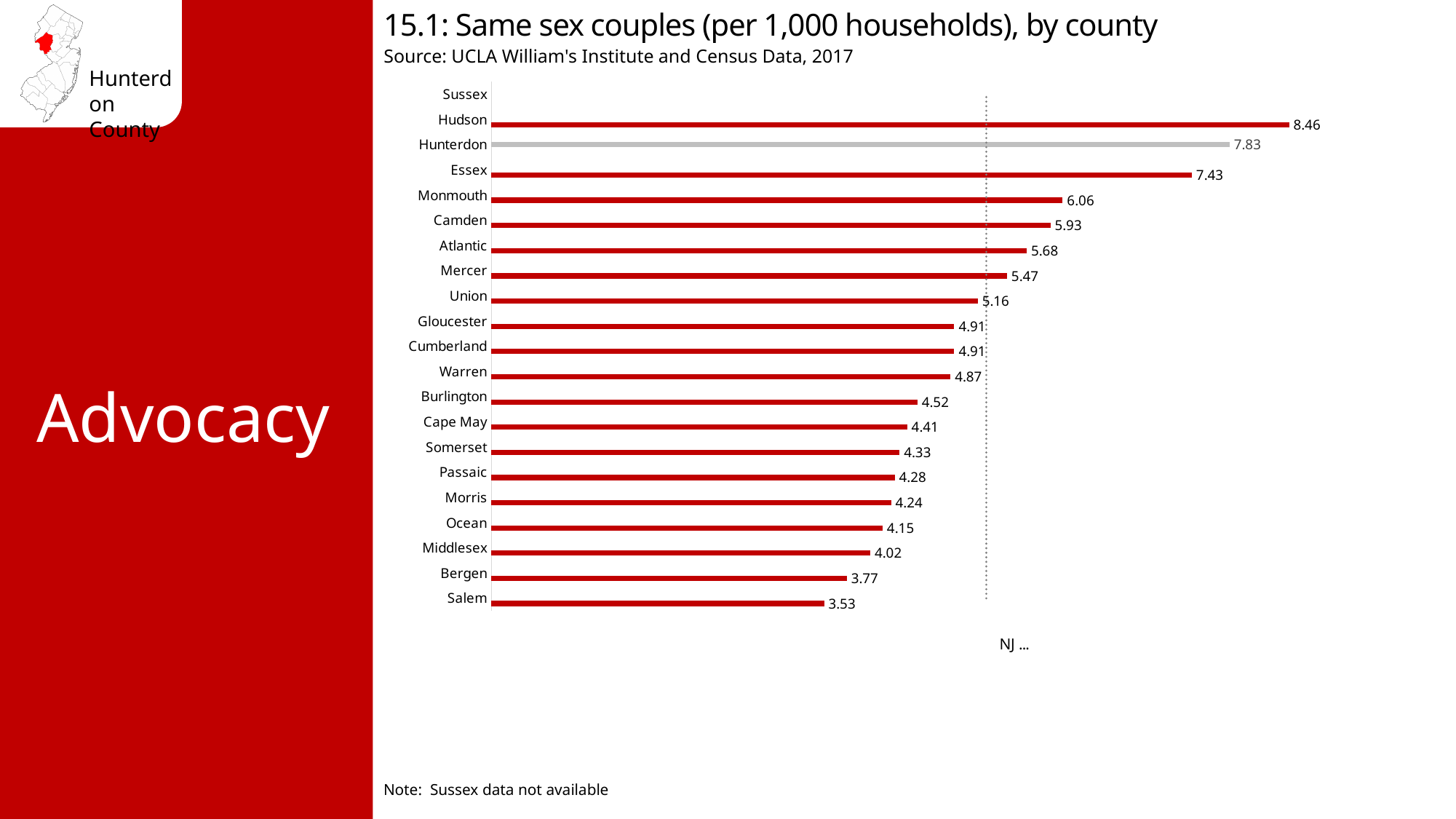
What kind of chart is shown on the slide? Bar chart What is the difference between the values for Hudson and Hunterdon? 0.63 What is the value for Salem? 3.53 What is the value for Hunterdon? 7.83 What is the value for Hudson? 8.46 Which has a larger value, Essex or Monmouth? Essex How many counties are listed on the chart's axis? 21 Which county has the lowest value shown? Salem What is the value for Cape May? 4.41 Which county has the highest value shown? Hudson According to the note, which county's data is not available? Sussex Which county's bar is coloured grey instead of red? Hunterdon